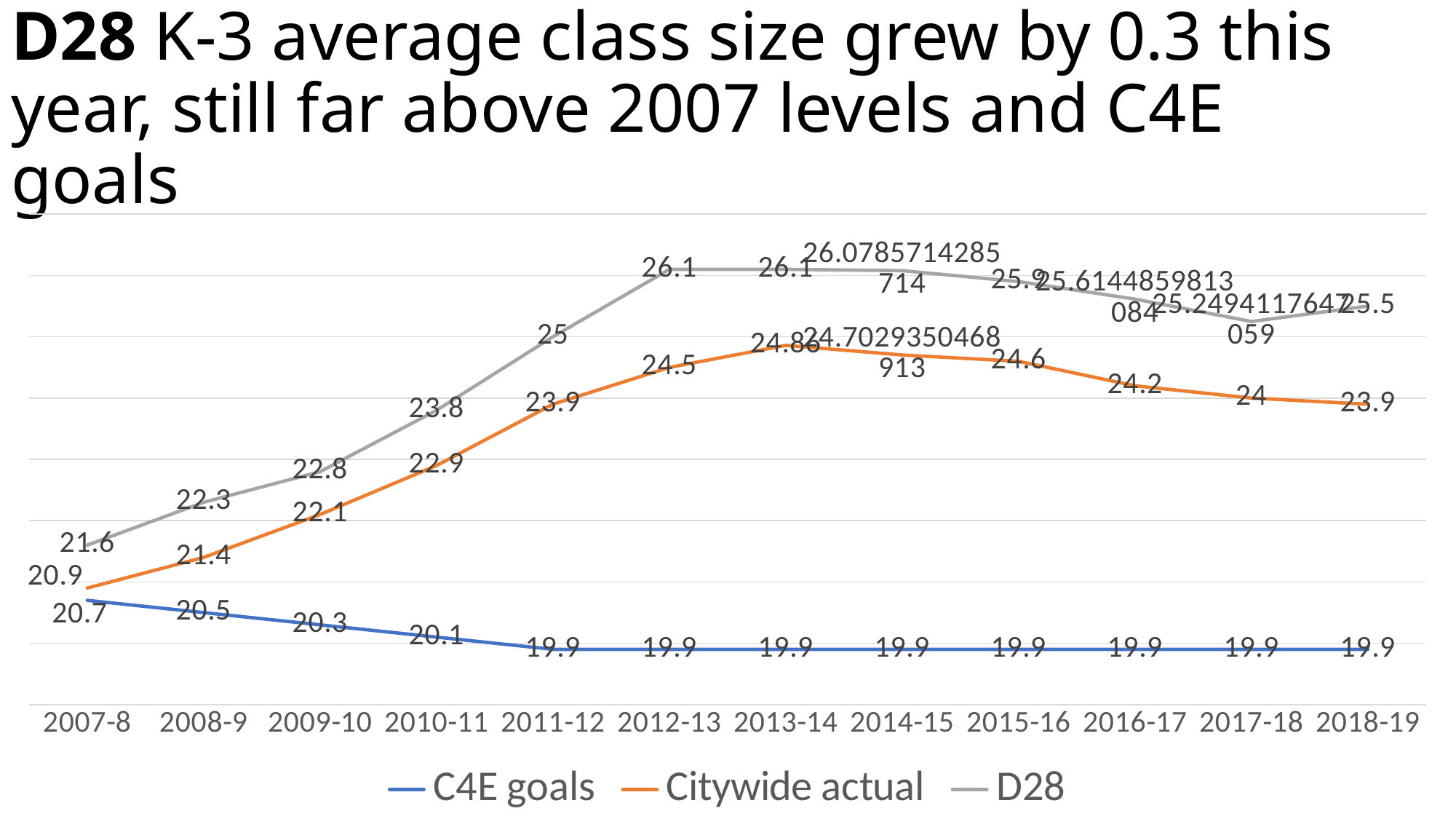
How many series does the legend list? 3 What is the D28 value for 2018-19? 25.5 What is the Citywide actual value for 2012-13? 24.5 Does the Citywide actual series rise or fall from 2007-8 to 2013-14? rise What is the difference between the D28 value and the Citywide actual value in 2018-19? 1.6 In 2011-12, which is larger: the D28 value or the Citywide actual value? D28 How many school years are plotted along the x axis? 12 What is the C4E goals value for 2007-8? 20.7 In which year is the Citywide actual series at its highest? 2013-14 In which year is the D28 series at its lowest? 2007-8 What kind of chart is shown on the slide? line chart What colour is the D28 line in the legend? gray